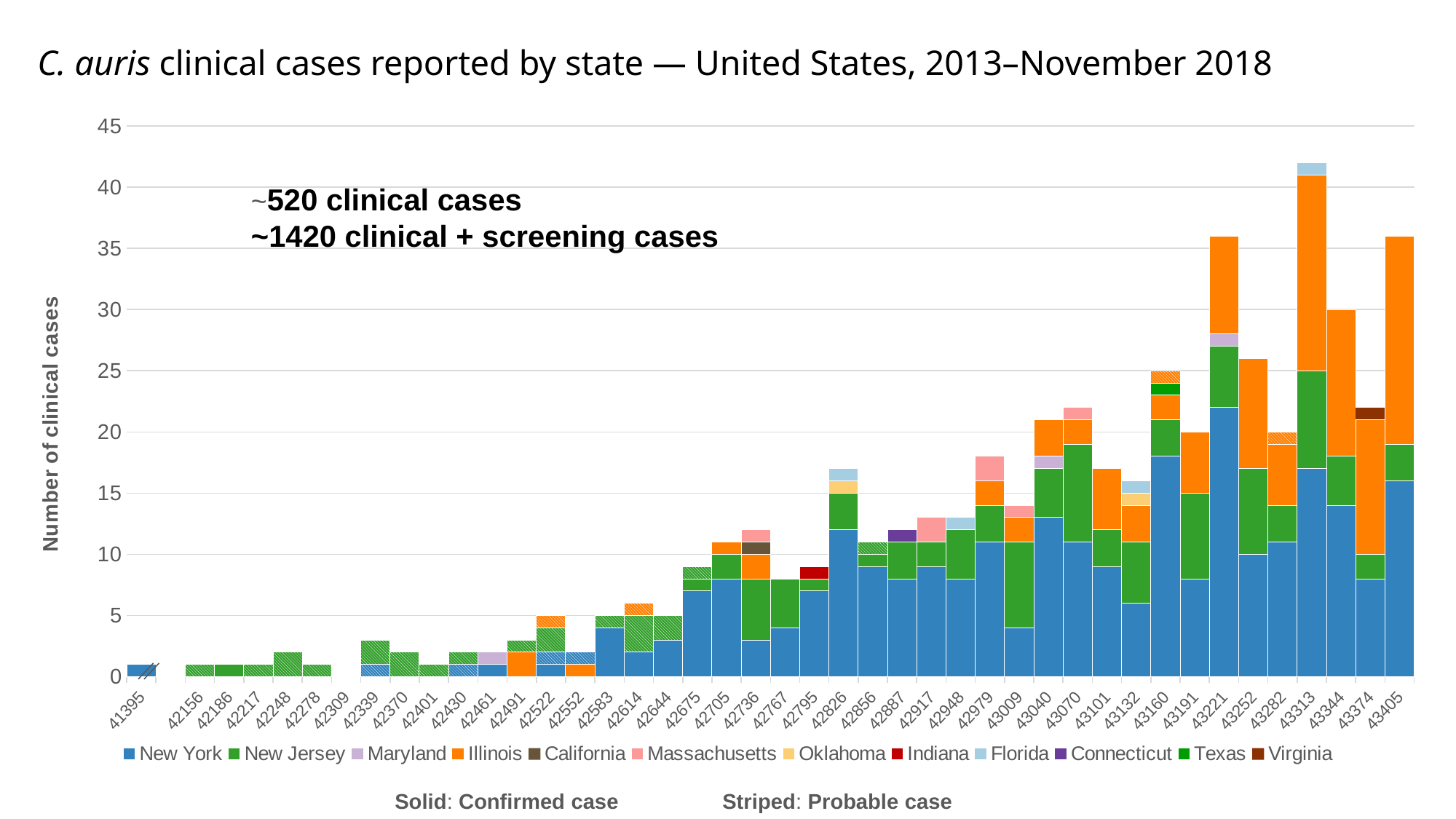
Is the total stacked value for 43374 greater or less than 20? greater What kind of chart is shown on the slide? Stacked bar chart Do the stacked bar totals generally rise or fall from left to right along the x axis? Rise Which has the taller stacked bar, 43221 or 43252? 43221 Which has the taller stacked bar, 43313 or 43344? 43313 Is the total stacked value for 42675 greater or less than 10? less Is the total stacked value for 43313 greater or less than 35? greater According to the note below the legend, what does a striped bar segment represent? Probable case Which x-axis category has the tallest stacked bar? 43313 How many series does the legend list? 12